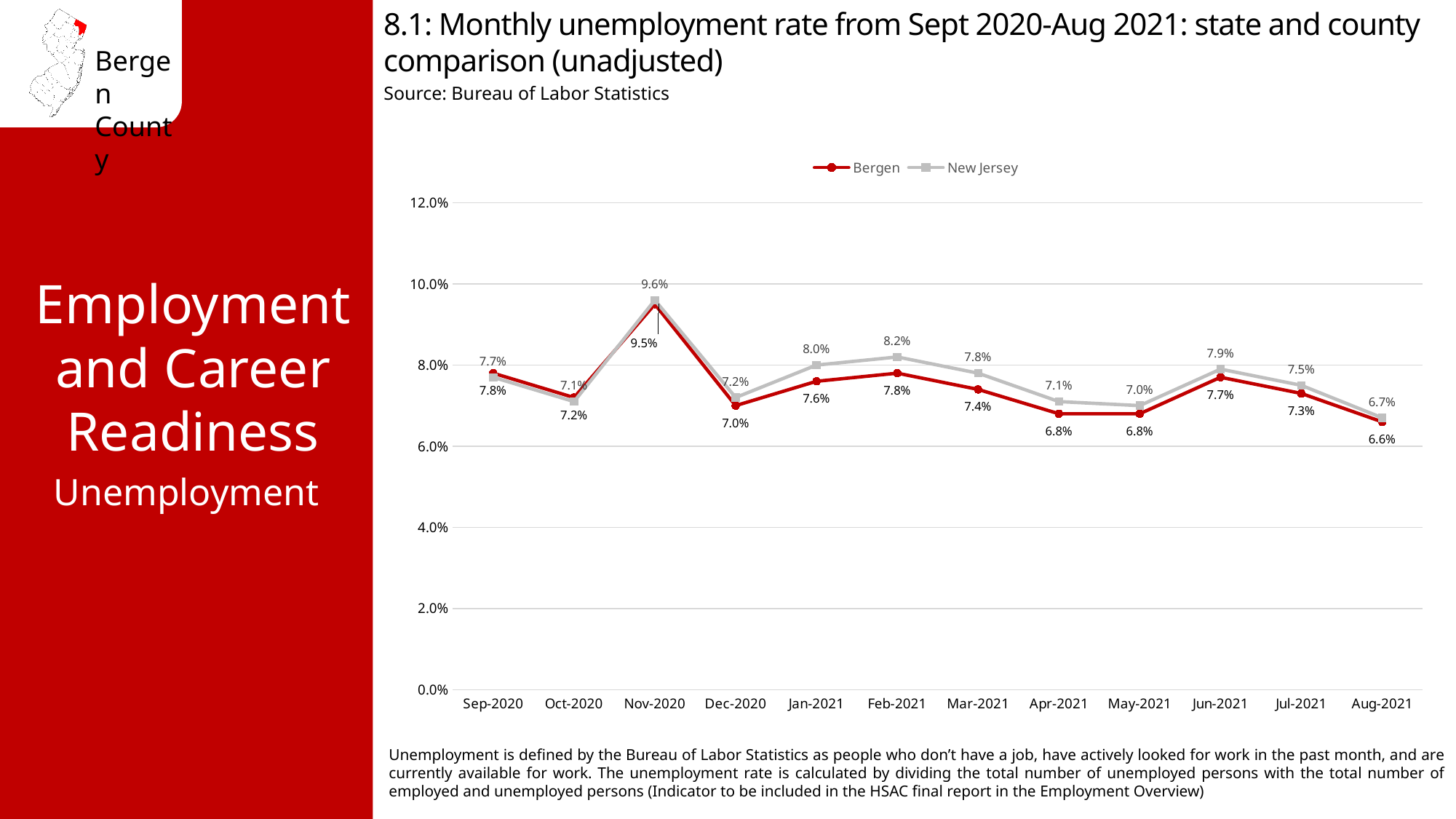
In which month did New Jersey have its highest unemployment rate? Nov-2020 Which series had the higher unemployment rate in Mar-2021, Bergen or New Jersey? New Jersey What is the difference between the New Jersey and Bergen unemployment rates in Jan-2021? 0.4% How many months are plotted along the x axis? 12 What colour is the Bergen line in the chart? Red How many series does the legend list? 2 What was the New Jersey unemployment rate in Feb-2021? 8.2% Did the Bergen unemployment rate rise or fall from Jun-2021 to Aug-2021? Fall What type of chart is shown on the slide? Line chart What was the Bergen unemployment rate in Aug-2021? 6.6% What was the Bergen unemployment rate in Nov-2020? 9.5% In which month did Bergen have its lowest unemployment rate? Aug-2021